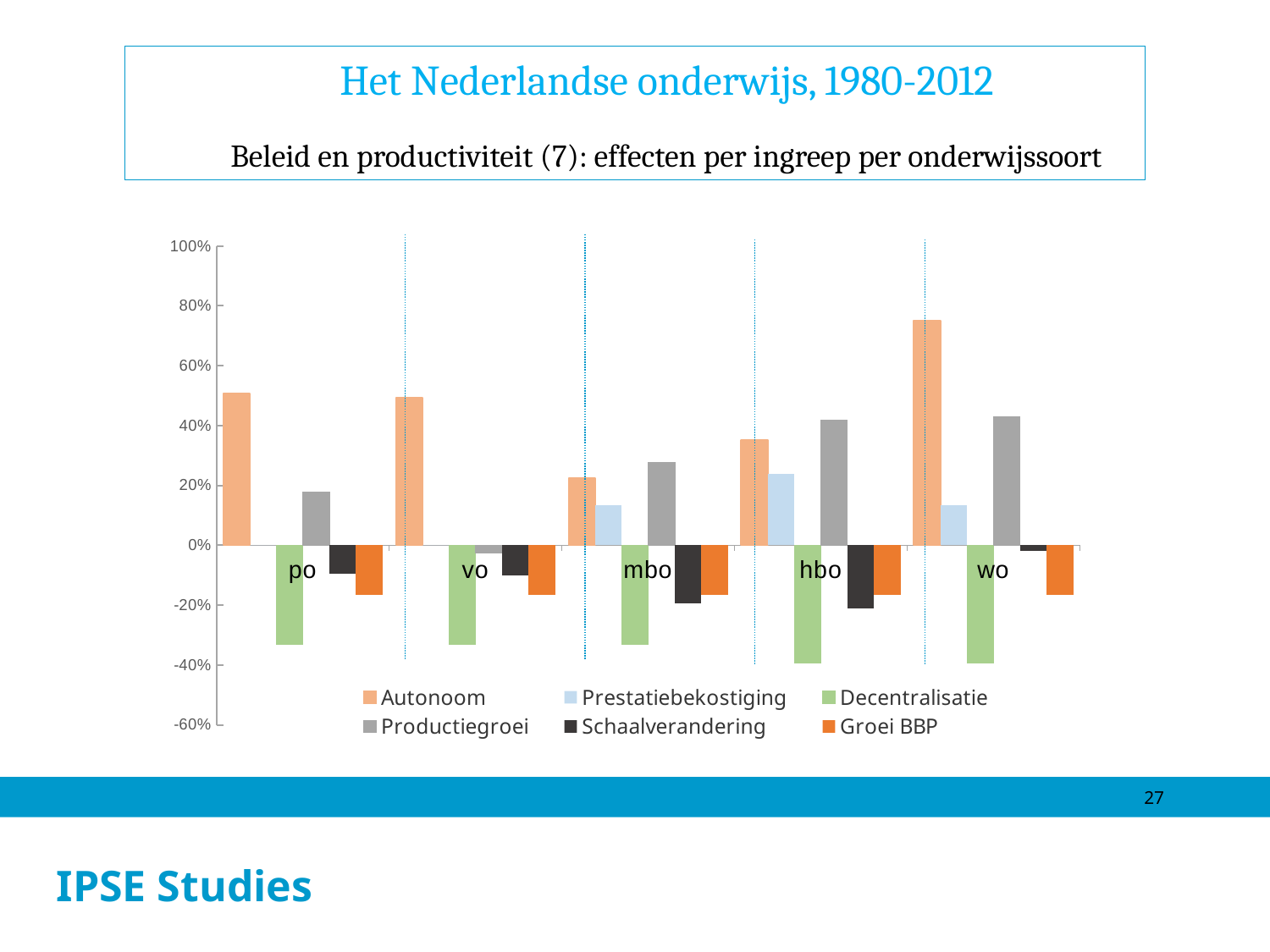
Is the Decentralisatie value for po greater or less than -20%? less Which category has the larger Prestatiebekostiging value: mbo or hbo? hbo For which category is the Autonoom value the lowest? mbo Is the Productiegroei value for wo greater or less than 20%? greater For which category is the Autonoom value the highest? wo How many series does the legend list? 6 Is the Autonoom value for wo greater or less than 60%? greater For hbo, which is larger: the Productiegroei value or the Autonoom value? Productiegroei What is the main title of the slide? Het Nederlandse onderwijs, 1980-2012 How many education categories are shown along the x axis? 5 What kind of chart is shown on the slide? bar chart